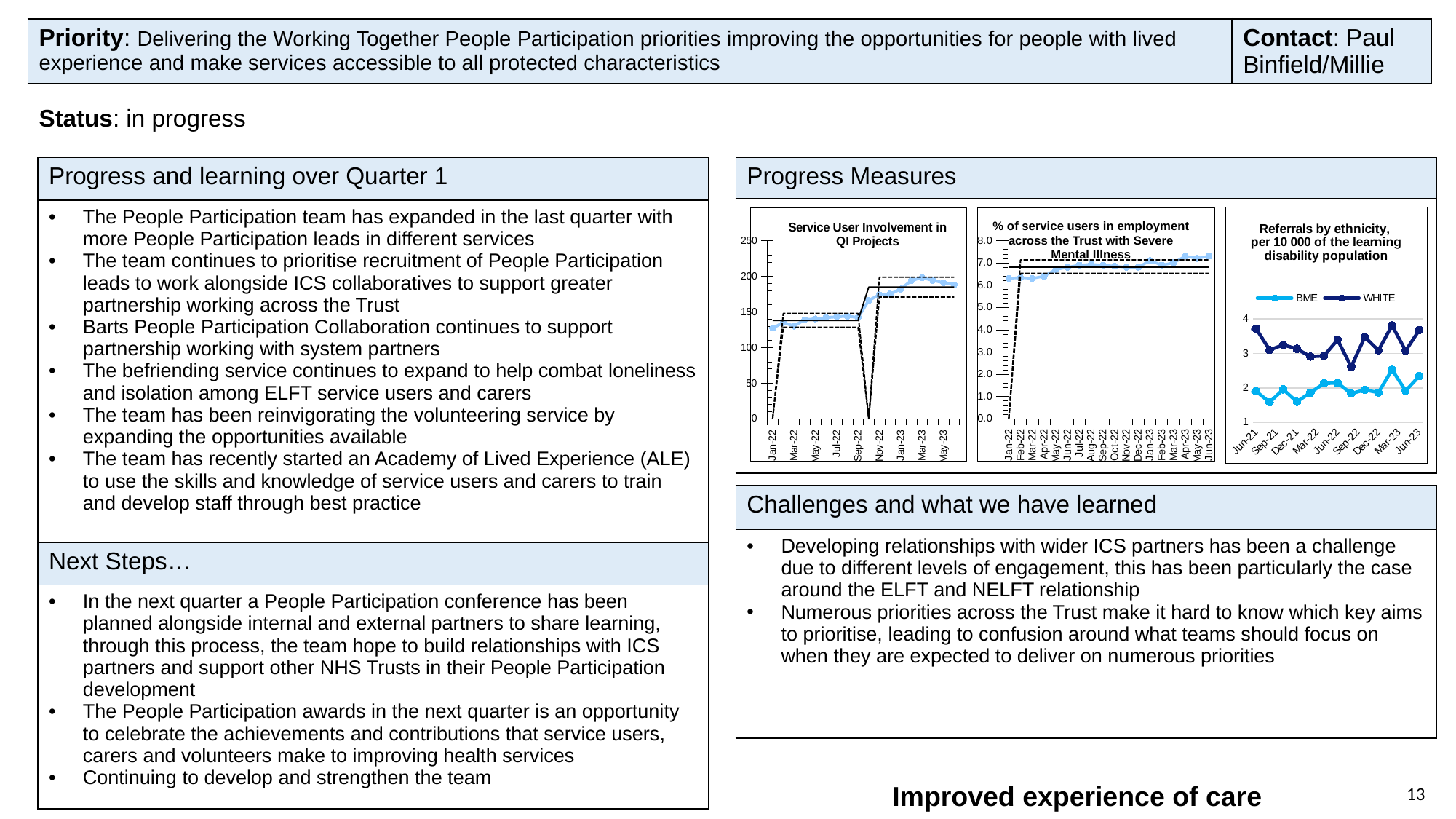
In the 'Referrals by ethnicity' chart, is the WHITE value for Jun-21 greater or less than 3? greater In the 'Referrals by ethnicity' chart, which series has the higher value at Jun-23, BME or WHITE? WHITE In the '% of service users in employment across the Trust with Severe Mental Illness' chart, is the value for Jun-23 greater or less than 6.0? greater What are the two series named in the legend of the 'Referrals by ethnicity' chart? BME and WHITE In the 'Service User Involvement in QI Projects' chart, is the value for Jan-22 greater or less than 100? greater In the 'Service User Involvement in QI Projects' chart, do the values overall rise or fall from Jan-22 to May-23? rise In the '% of service users in employment across the Trust with Severe Mental Illness' chart, do the values rise or fall from Jan-22 to Jun-23? rise How many series does the legend of the 'Referrals by ethnicity' chart list? 2 What is the title of the rightmost chart in the Progress Measures section? Referrals by ethnicity, per 10 000 of the learning disability population What type of chart is the 'Service User Involvement in QI Projects' chart? Line chart